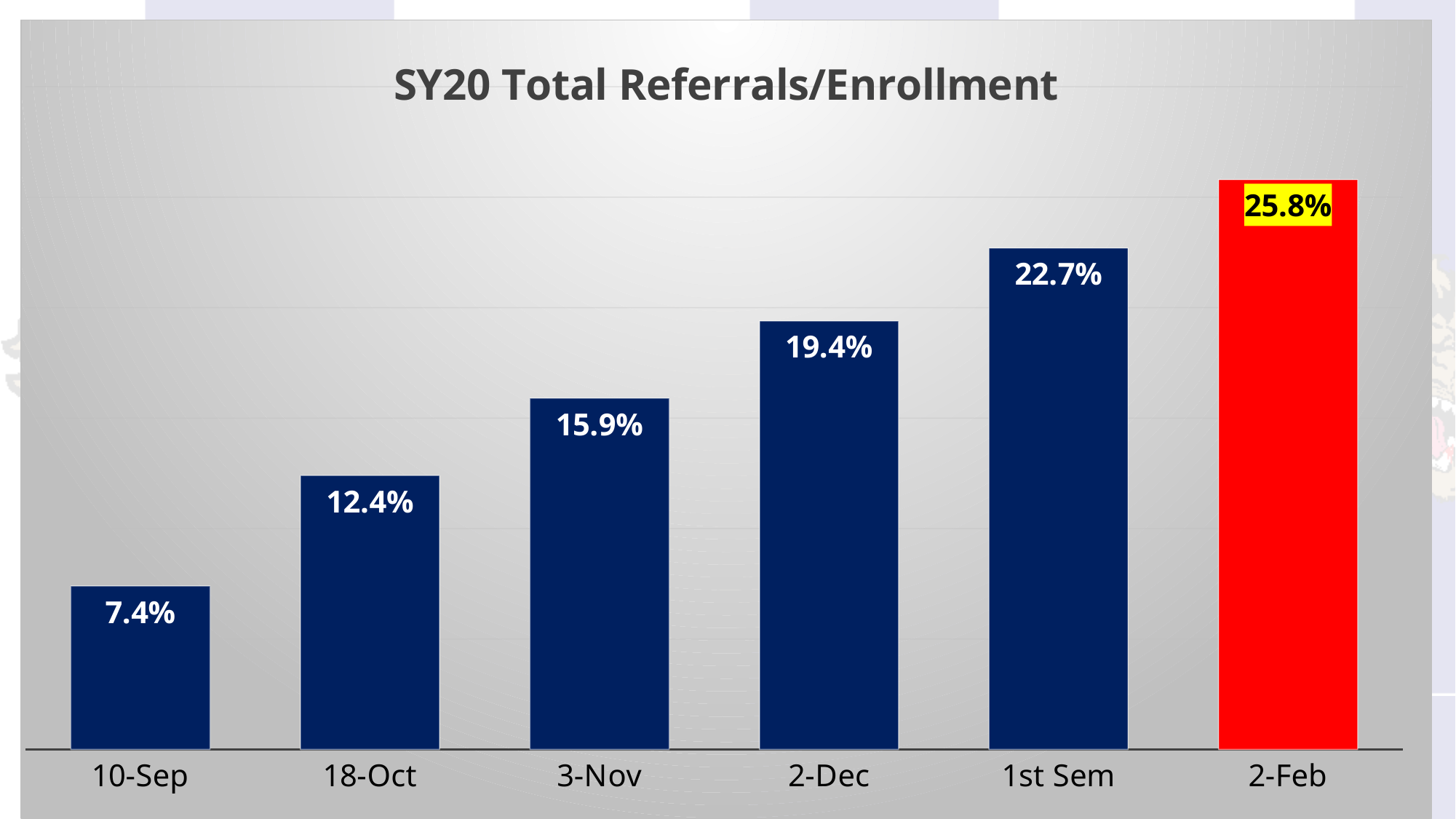
What is the value for 2-Dec? 19.4% What kind of chart is this? Bar chart Which category has the highest value? 2-Feb Do the values rise or fall from 10-Sep to 2-Feb? Rise Which is larger, the value for 3-Nov or the value for 2-Dec? 2-Dec What is the title of the chart? SY20 Total Referrals/Enrollment What is the difference between the values for 2-Feb and 1st Sem? 3.1% What is the difference between the values for 18-Oct and 10-Sep? 5.0% Which category has the lowest value? 10-Sep What is the value for 10-Sep? 7.4% How many categories are shown on the x axis? 6 What is the value for 1st Sem? 22.7%